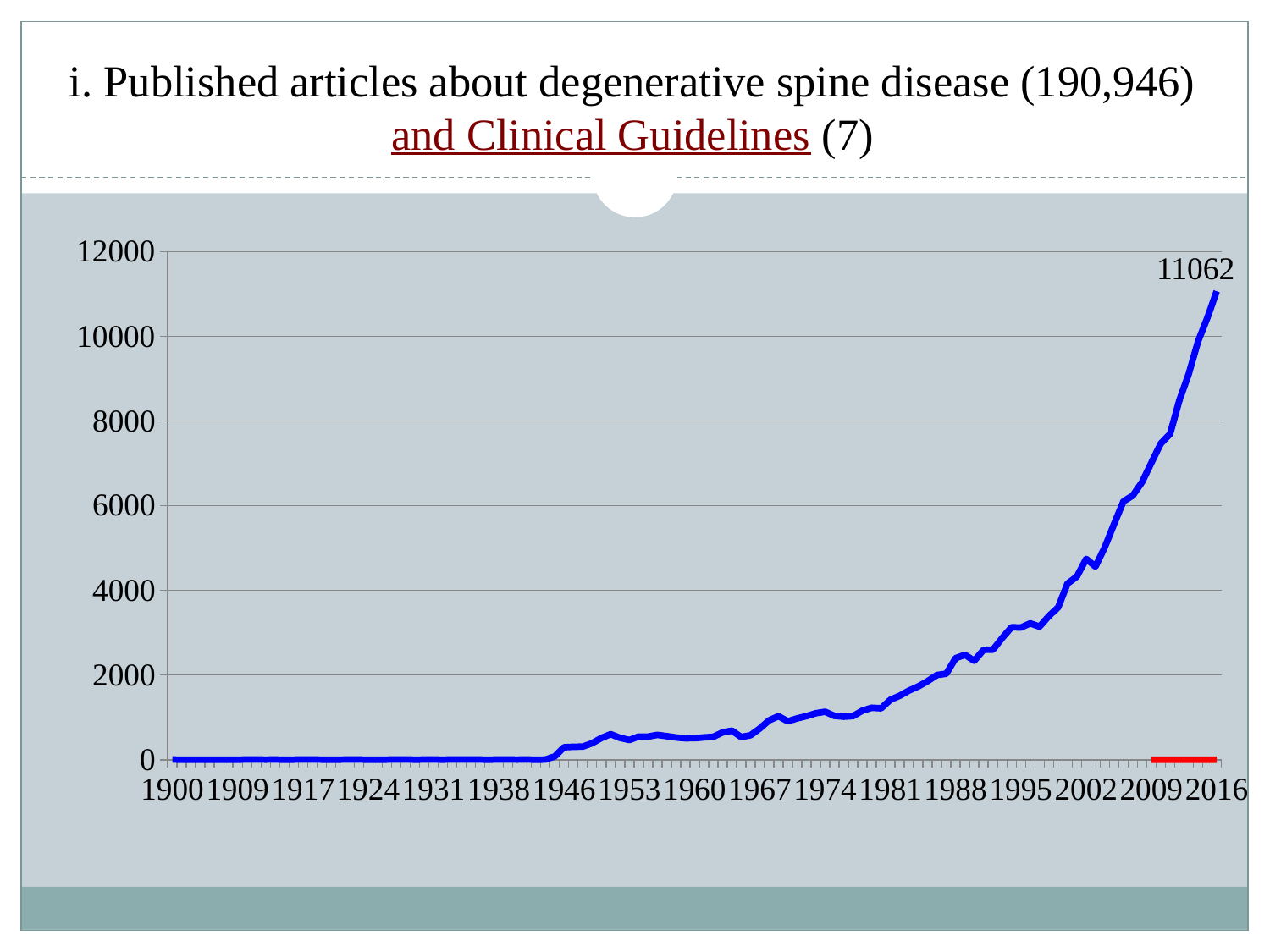
What is the highest tick value shown on the vertical axis? 12000 Is the value of the blue line for 1988 greater or less than 4000? less Which year has the larger value on the blue line, 1981 or 2002? 2002 What value is printed as the data label at the end of the blue line in 2016? 11062 What kind of chart is shown on the slide? line chart Is the value of the blue line for 2016 greater or less than 10000? greater Do the values of the blue line generally rise or fall from 1900 to 2016? rise In which year does the blue line reach its highest value? 2016 What colour is the main line showing published articles? blue Is the value of the blue line for 2009 greater or less than 6000? greater How many year labels are shown along the horizontal axis? 17